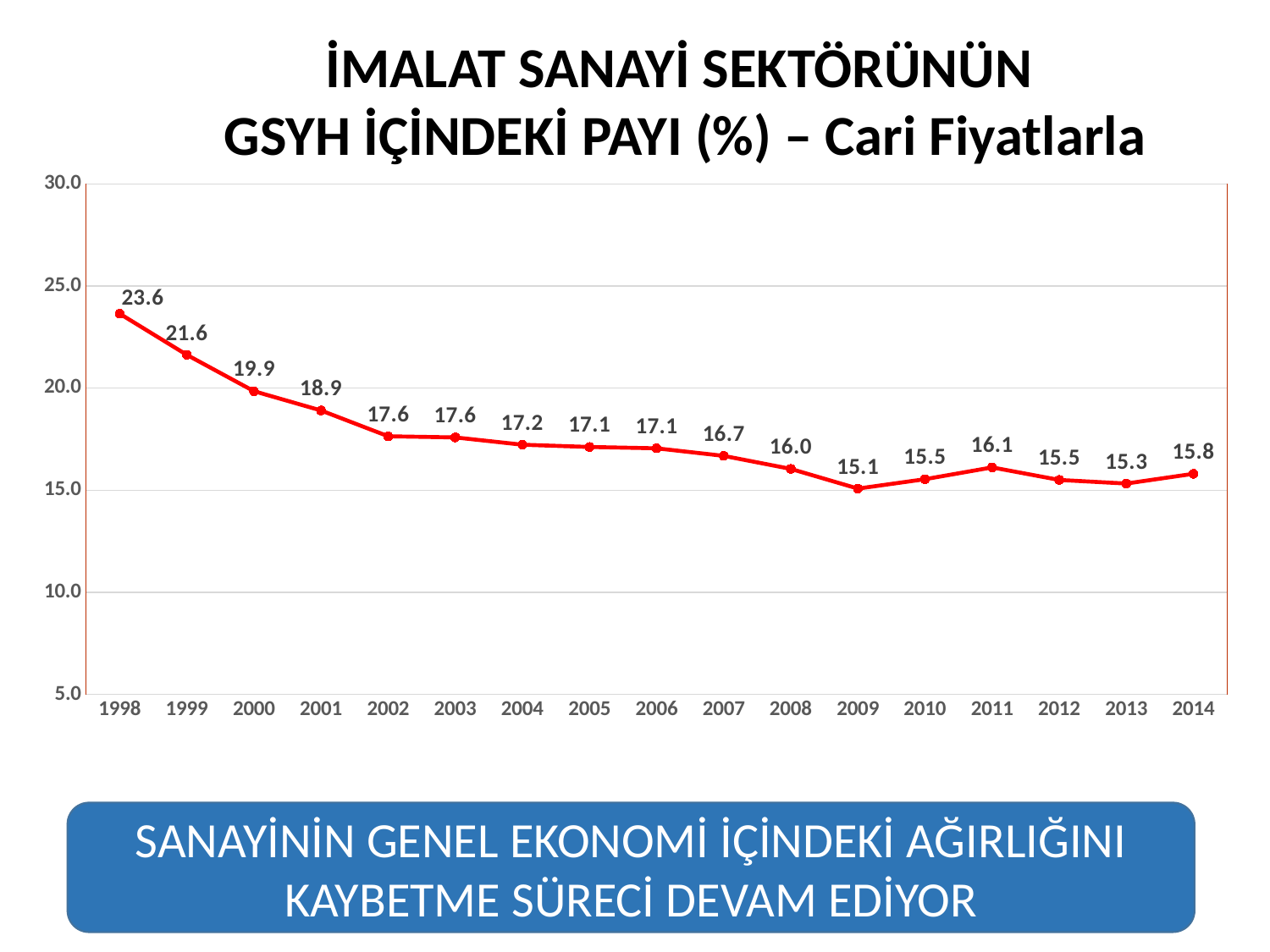
How many years are plotted on the chart? 17 Which is larger, the value for 2011 or the value for 2013? 2011 What kind of chart is shown? line chart What is the value for 1998? 23.6 What is the value for 2014? 15.8 Is the value for 2001 greater or less than 20.0? less Which year has the lowest value? 2009 Do the values generally rise or fall from 1998 to 2009? fall What is the difference between the values for 1998 and 2014? 7.8 Which year has the highest value? 1998 What colour is the plotted line? red What is the value for 2009? 15.1